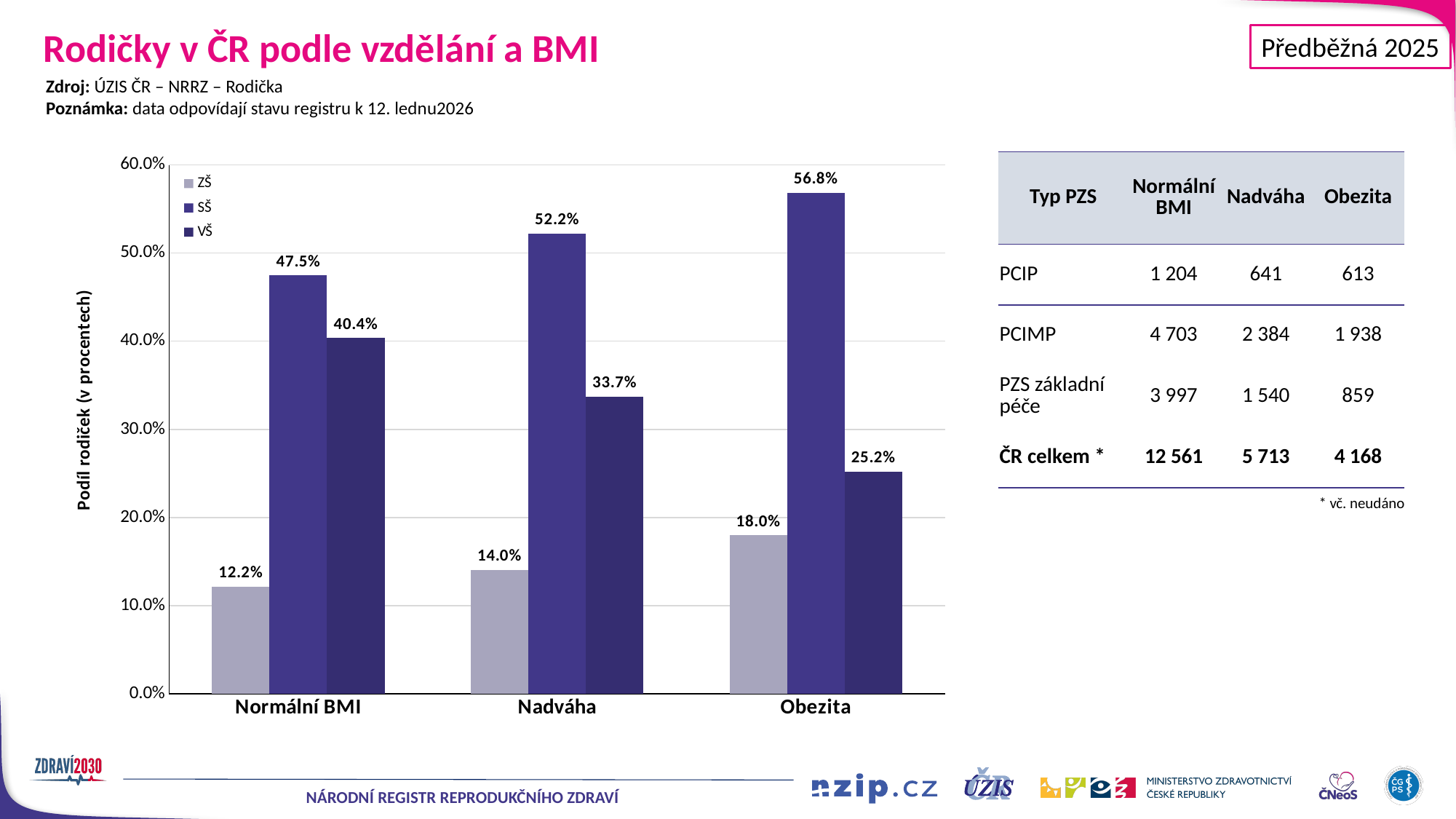
What is the difference between the SŠ and VŠ values in the Normální BMI category? 7.1 percentage points What kind of chart is shown on the slide? Bar chart How many categories are shown on the x axis of the chart? 3 What is the value for SŠ in the Obezita category? 56.8% Is the value for SŠ in the Nadváha category greater or less than 50.0%? greater Which category has the highest value for the VŠ series? Normální BMI What is the value for VŠ in the Nadváha category? 33.7% Which category has the lowest value for the ZŠ series? Normální BMI What is the value for ZŠ in the Normální BMI category? 12.2% How many series does the chart legend list? 3 What is the difference between the SŠ values for Obezita and Nadváha? 4.6 percentage points Which is larger: the VŠ value for Obezita or the ZŠ value for Obezita? VŠ